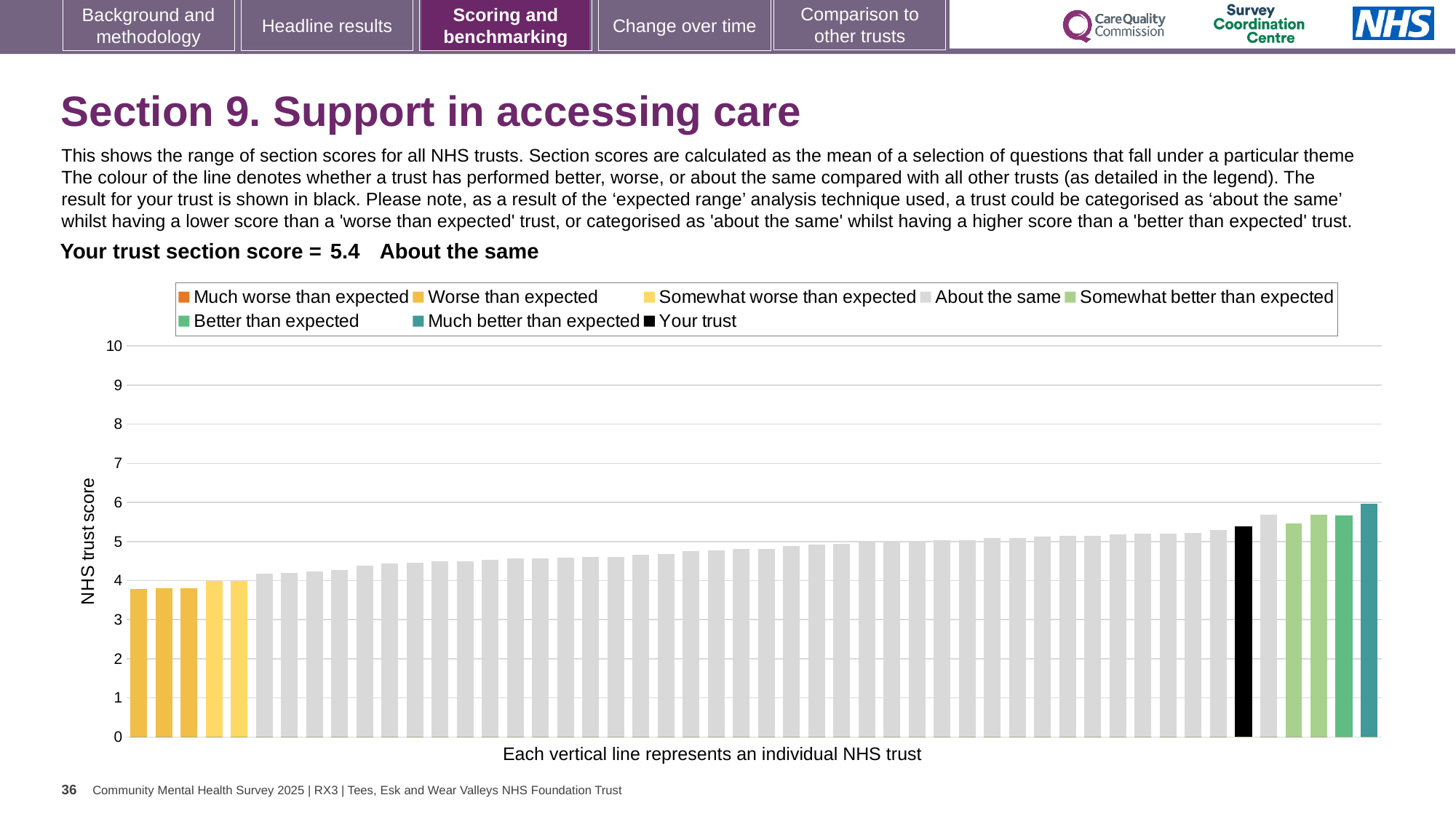
Do the bar values rise or fall from left to right along the x axis? rise Is the value of the lowest bar in the chart greater or less than 4? less What colour is the bar representing your trust? black Is the value of the black 'Your trust' bar greater or less than 5? greater Is the value of the highest bar in the chart greater or less than 5? greater What is the section score for your trust shown on the slide? 5.4 Which legend category does the highest bar in the chart belong to? Much better than expected What is the label on the vertical axis of the chart? NHS trust score How many entries does the chart legend list? 8 What kind of chart is shown on the slide? bar chart How many bars are coloured as 'Worse than expected'? 3 Which category is your trust's section score placed in? About the same